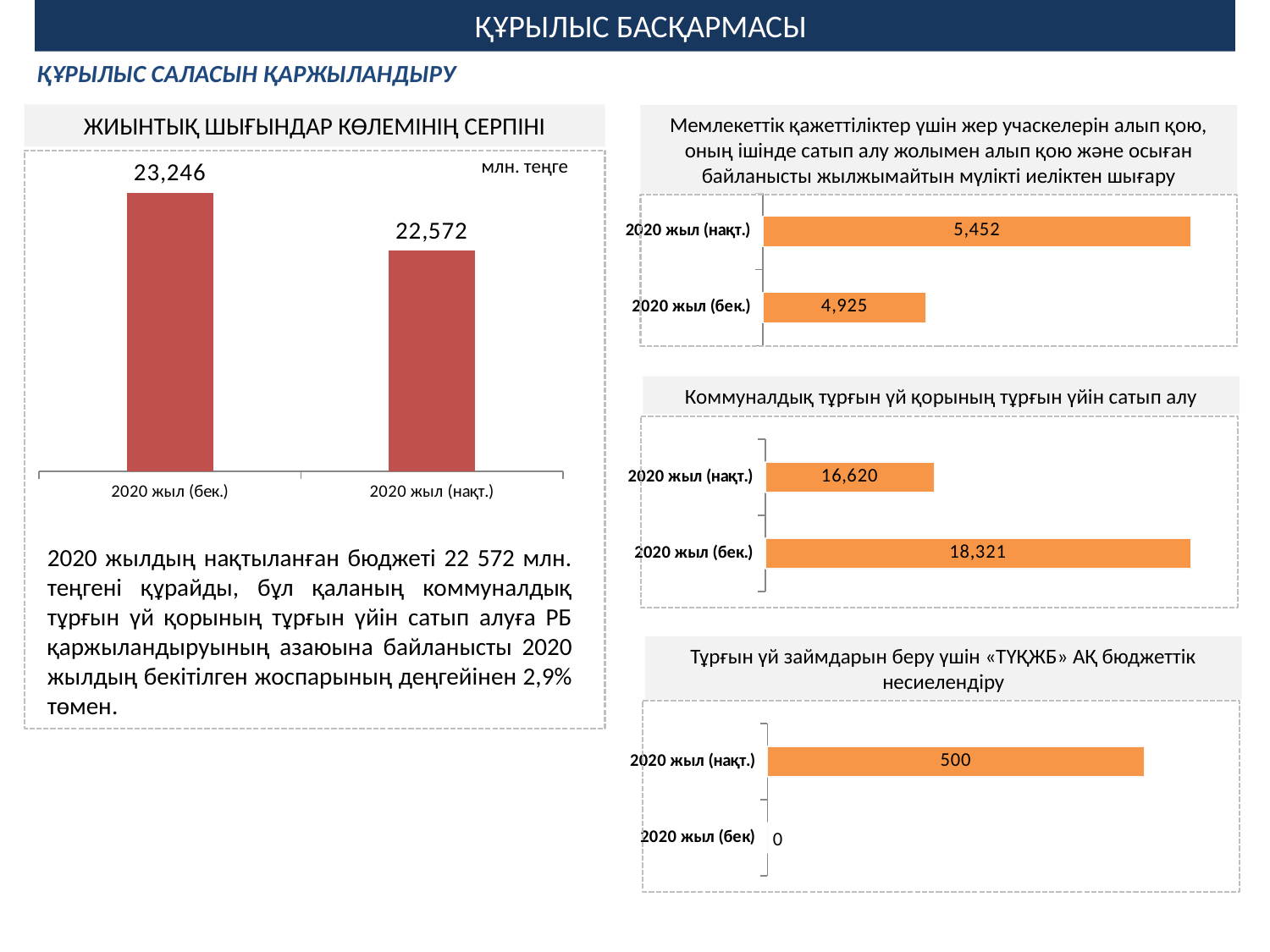
In the top-right chart about land plots for state needs (Мемлекеттік қажеттіліктер үшін жер учаскелерін алып қою), what is the value for 2020 жыл (нақт.)? 5,452 In the bottom-right chart 'Тұрғын үй займдарын беру үшін «ТҮҚЖБ» АҚ бюджеттік несиелендіру', which category has the lowest value? 2020 жыл (бек) In the top-right chart about land plots for state needs (Мемлекеттік қажеттіліктер үшін жер учаскелерін алып қою), what is the value for 2020 жыл (бек.)? 4,925 What kind of chart is the top-left chart 'ЖИЫНТЫҚ ШЫҒЫНДАР КӨЛЕМІНІҢ СЕРПІНІ'? bar chart In the top-left chart 'ЖИЫНТЫҚ ШЫҒЫНДАР КӨЛЕМІНІҢ СЕРПІНІ', what is the value for 2020 жыл (бек.)? 23,246 In the top-left chart 'ЖИЫНТЫҚ ШЫҒЫНДАР КӨЛЕМІНІҢ СЕРПІНІ', what is the value for 2020 жыл (нақт.)? 22,572 In the middle-right chart 'Коммуналдық тұрғын үй қорының тұрғын үйін сатып алу', what is the value for 2020 жыл (бек.)? 18,321 In the middle-right chart 'Коммуналдық тұрғын үй қорының тұрғын үйін сатып алу', what is the difference between the 2020 жыл (бек.) and 2020 жыл (нақт.) values? 1,701 In the top-right chart about land plots for state needs, which category has the higher value, 2020 жыл (нақт.) or 2020 жыл (бек.)? 2020 жыл (нақт.) In the top-left chart 'ЖИЫНТЫҚ ШЫҒЫНДАР КӨЛЕМІНІҢ СЕРПІНІ', what is the difference between the 2020 жыл (бек.) and 2020 жыл (нақт.) values? 674 In the top-left chart 'ЖИЫНТЫҚ ШЫҒЫНДАР КӨЛЕМІНІҢ СЕРПІНІ', what unit is shown for the values? млн. теңге In the bottom-right chart 'Тұрғын үй займдарын беру үшін «ТҮҚЖБ» АҚ бюджеттік несиелендіру', what is the value for 2020 жыл (нақт.)? 500